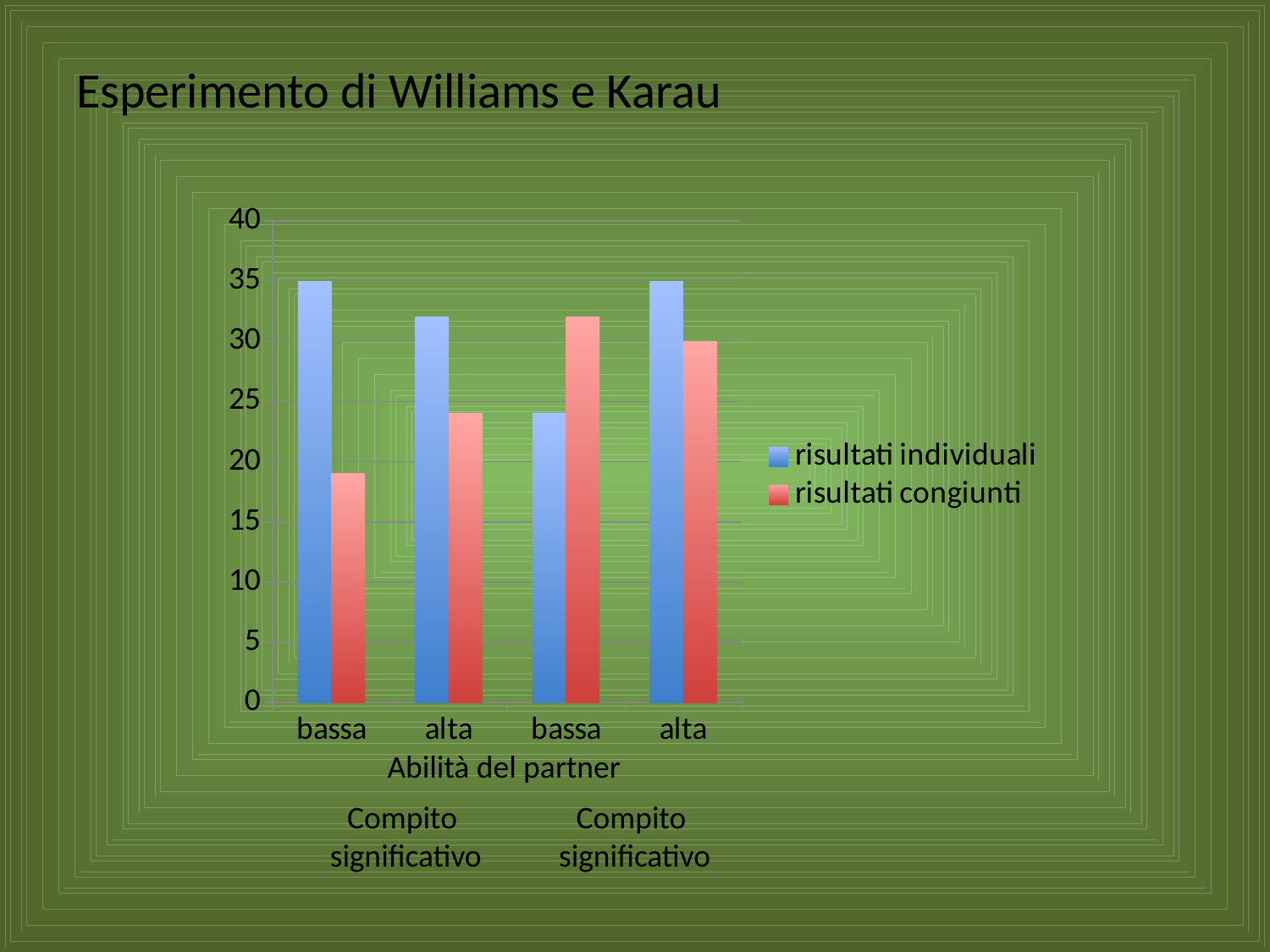
How many categories are shown on the x axis? 4 Which category has the lowest 'risultati congiunti' value? the first 'bassa' (leftmost group) What is the title of the x axis? Abilità del partner What is the value of 'risultati individuali' for the last 'alta' category (rightmost group)? 35 How many series does the legend list? 2 Is the value of 'risultati congiunti' for the second 'alta' category (rightmost group) greater or less than 25? greater In the second 'bassa' category (third group), which is larger: 'risultati individuali' or 'risultati congiunti'? risultati congiunti In the first 'bassa' category (leftmost group), which is larger: 'risultati individuali' or 'risultati congiunti'? risultati individuali Is the value of 'risultati individuali' for the second 'bassa' category (third group) greater or less than 30? less What kind of chart is shown on the slide? bar chart Is the value of 'risultati congiunti' for the first 'bassa' category (leftmost group) greater or less than 20? less What is the value of 'risultati individuali' for the first 'bassa' category (leftmost group)? 35